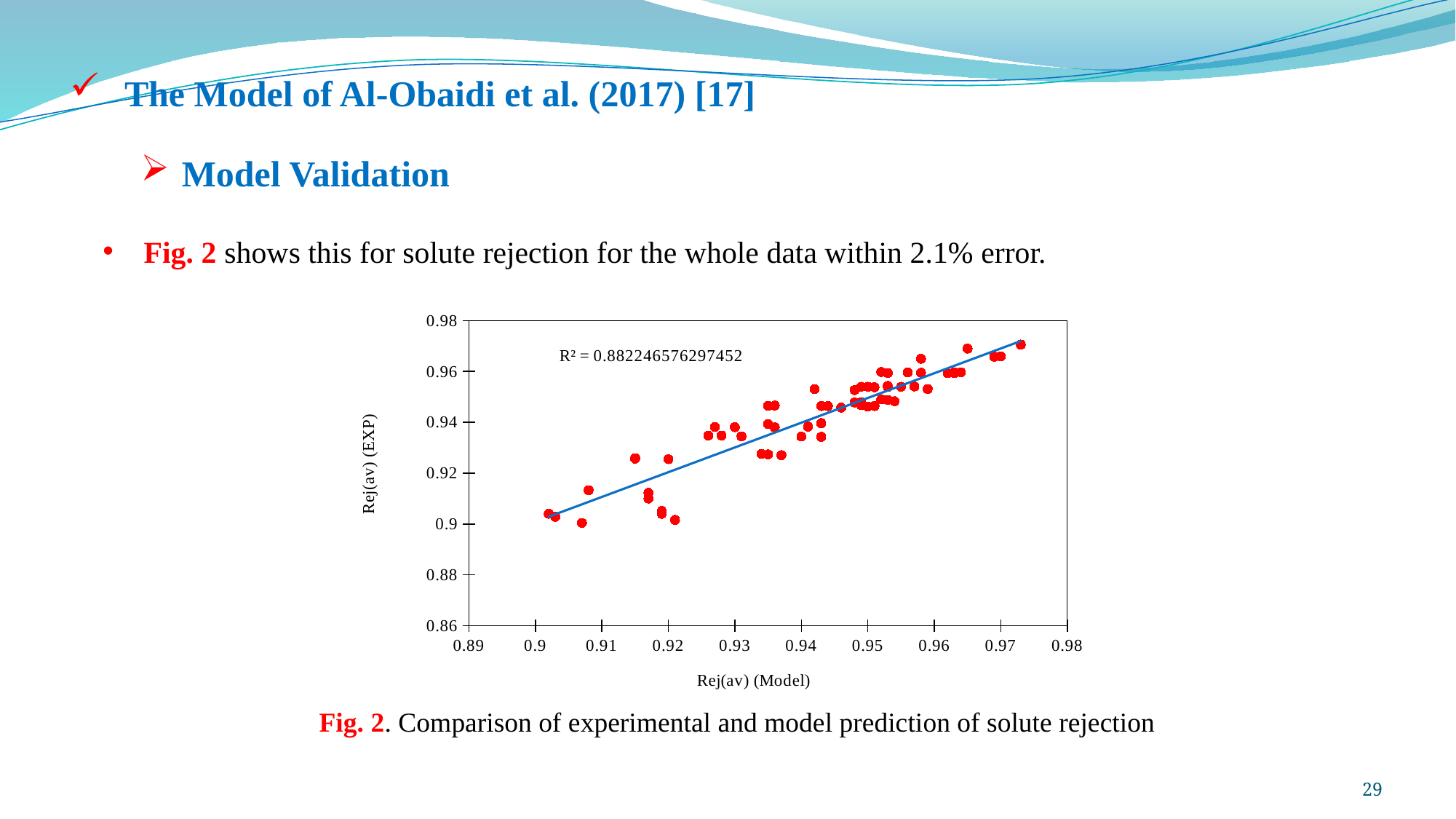
Are the experimental values for the points with model values near 0.95 greater or less than 0.94? greater Do the experimental rejection values generally rise or fall as the model rejection values increase along the x axis? rise What is the highest value shown on the y axis of the chart? 0.98 What kind of chart is shown on the slide? scatter chart Is the experimental value for the rightmost point (model value near 0.973) greater or less than 0.96? greater What is the lowest value shown on the x axis of the chart? 0.89 What R² value is printed on the chart? R² = 0.882246576297452 What is the label of the x axis of the chart? Rej(av) (Model) Is the experimental value for the lowest point near a model value of 0.92 greater or less than 0.92? less What is the label of the y axis of the chart? Rej(av) (EXP)